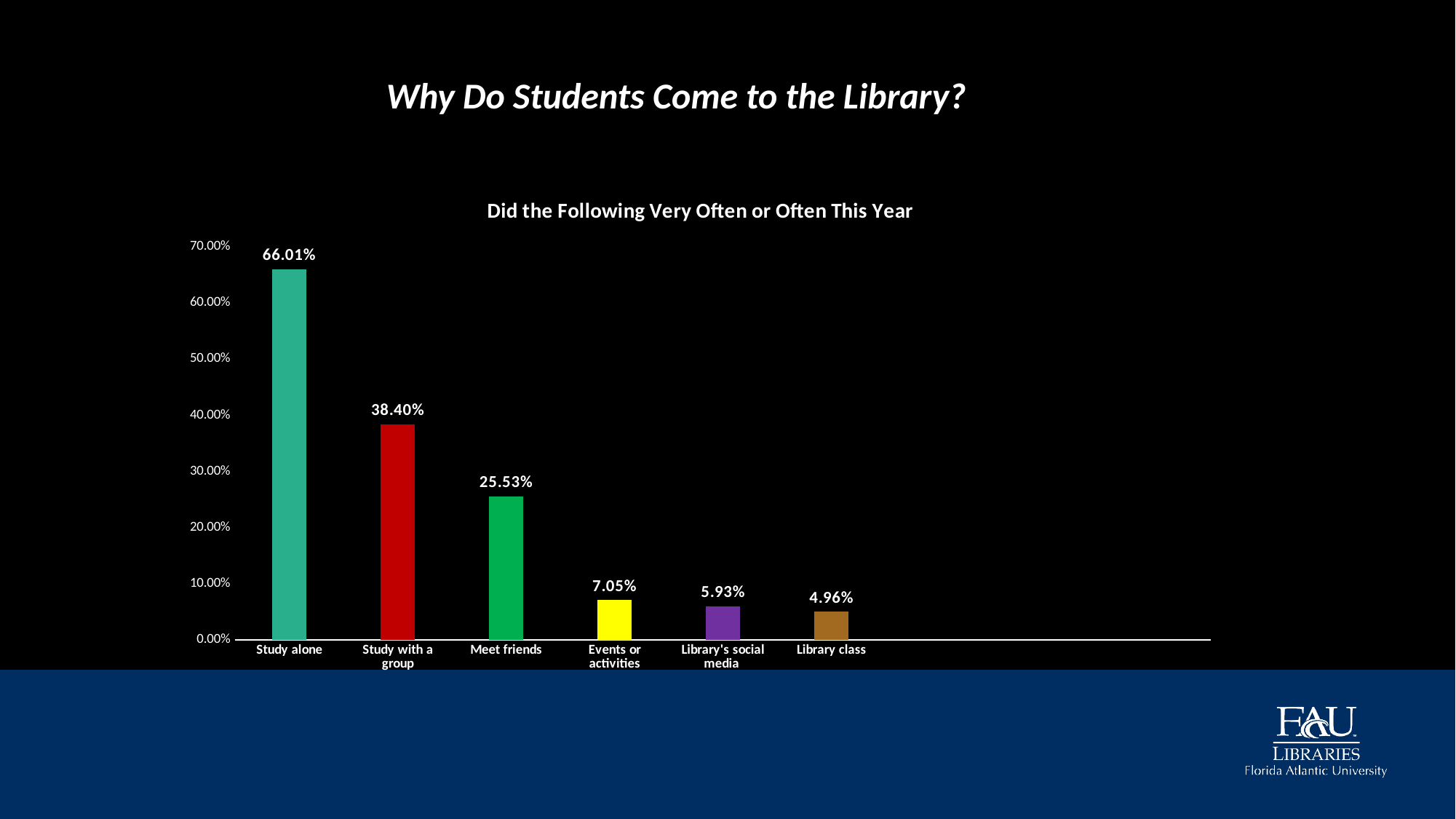
Is the value for 'Meet friends' greater or less than 30.00%? less Which category has the highest value in the chart? Study alone What is the title of the chart? Did the Following Very Often or Often This Year What kind of chart is shown on the slide? Bar chart What percentage of students reported studying alone very often or often this year? 66.01% What is the value shown for 'Library's social media'? 5.93% Which category has the lowest value in the chart? Library class What is the value shown for 'Events or activities'? 7.05% What is the difference between the values for 'Study alone' and 'Study with a group'? 27.61% What is the difference between the values for 'Meet friends' and 'Library class'? 20.57% How many categories are shown on the x axis of the chart? 6 Which is larger, the value for 'Study with a group' or the value for 'Meet friends'? Study with a group